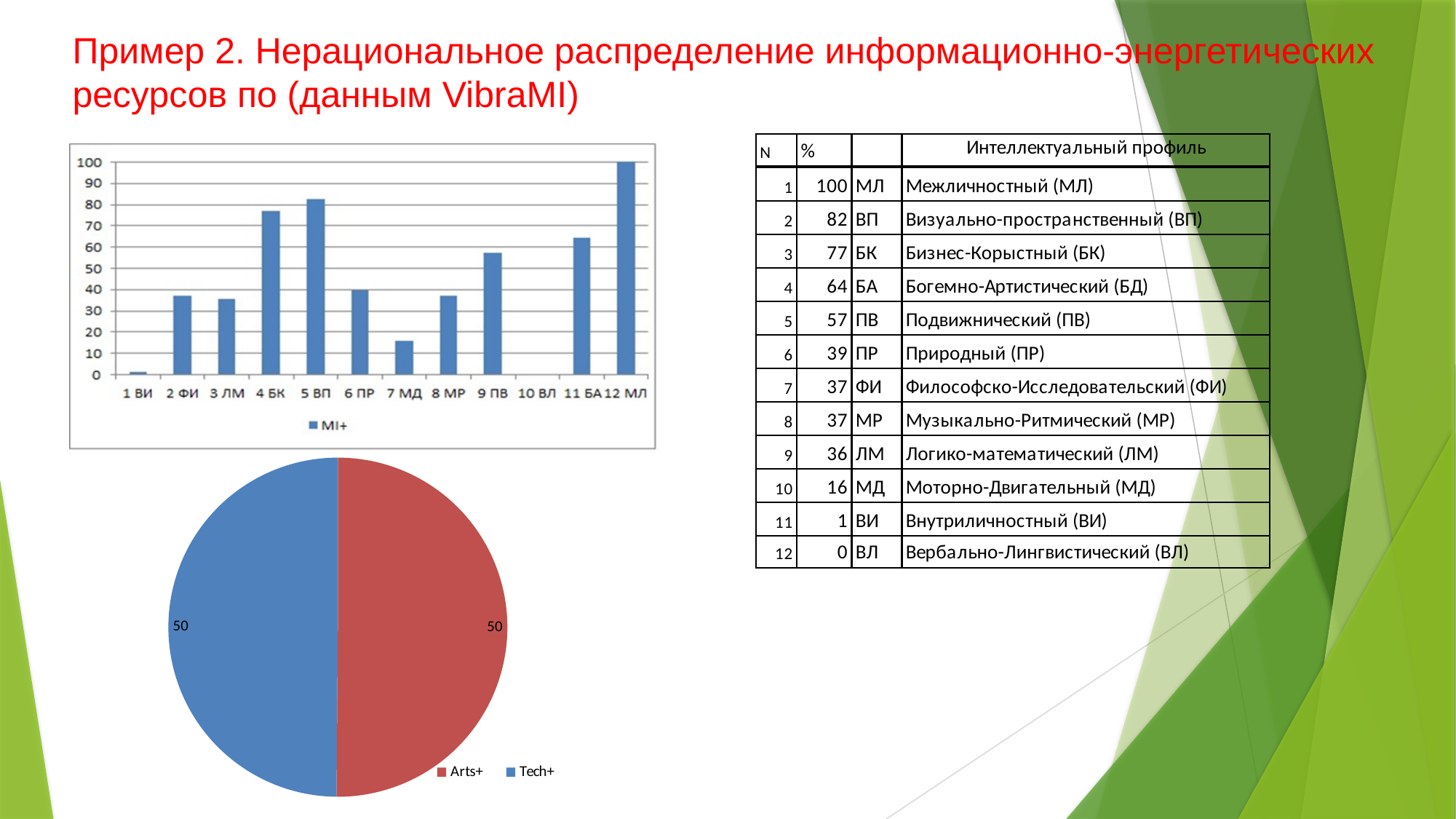
In the bar chart, what series name is shown in the legend? MI+ In the bar chart, which is larger, the value for 4 БК or the value for 6 ПР? 4 БК In the bar chart, is the value for 9 ПВ greater or less than 50? greater In the pie chart, how many slices are there? 2 In the bar chart, is the value for 7 МД greater or less than 20? less In the pie chart, what is the value of the Arts+ slice? 50 In the bar chart, which category has the highest bar? 12 МЛ What kind of chart is the top-left chart on the slide? bar chart In the bar chart, how many categories are shown on the x axis? 12 In the bar chart, what is the value for 12 МЛ? 100 In the bar chart, is the value for 5 ВП greater or less than 80? greater What kind of chart is the bottom chart on the slide? pie chart